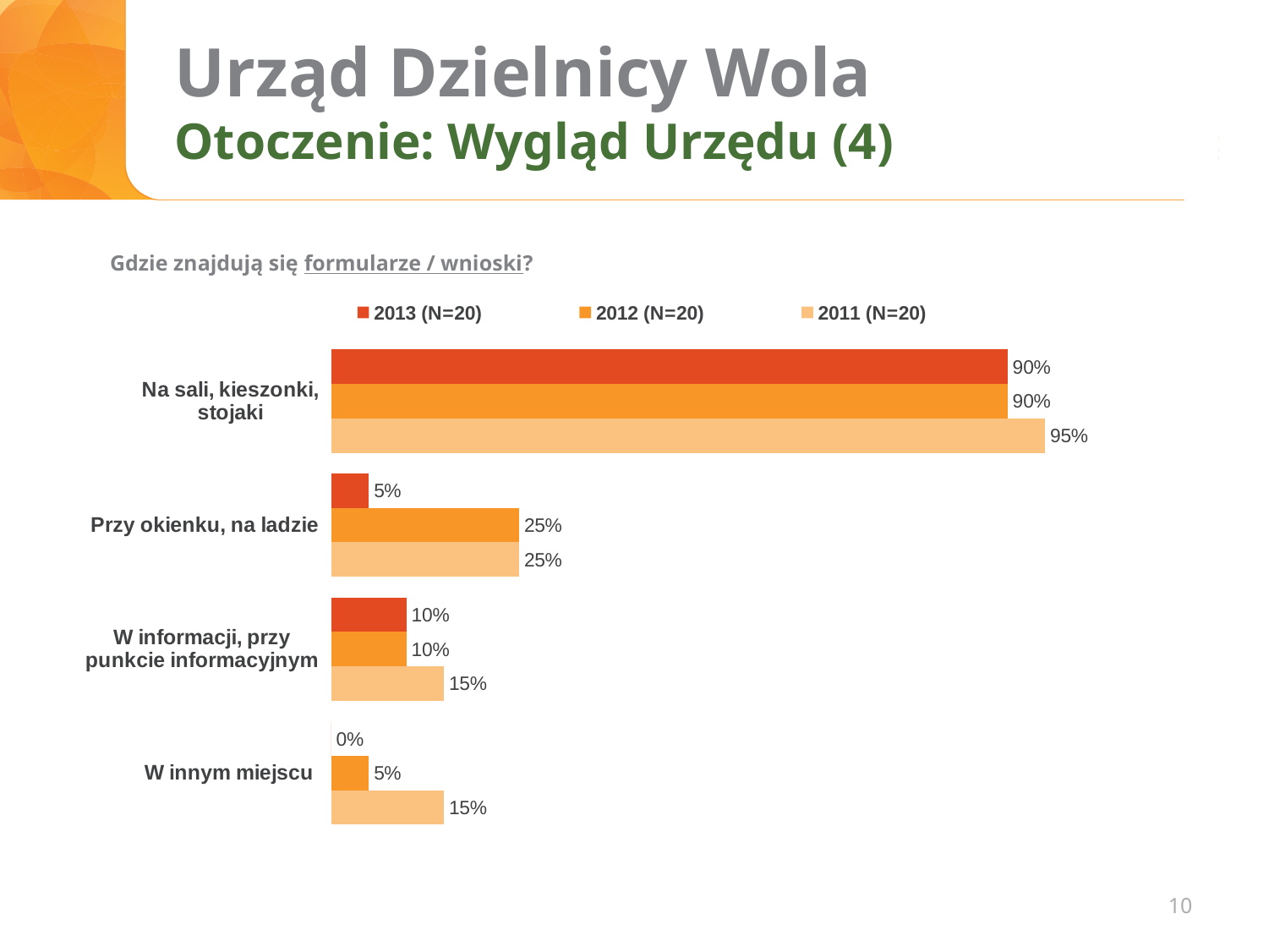
How many categories are shown on the chart? 4 Which category has the highest value in the 2011 (N=20) series? Na sali, kieszonki, stojaki What is the difference between the 2012 (N=20) and 2013 (N=20) values for "Przy okienku, na ladzie"? 20% What is the value for "W informacji, przy punkcie informacyjnym" in the 2013 (N=20) series? 10% Which category has the lowest value in the 2013 (N=20) series? W innym miejscu What is the value for "Na sali, kieszonki, stojaki" in the 2013 (N=20) series? 90% What is the value for "W innym miejscu" in the 2011 (N=20) series? 15% What is the value for "Przy okienku, na ladzie" in the 2012 (N=20) series? 25% How many series does the legend list? 3 What question does the chart answer, according to the text above it? Gdzie znajdują się formularze / wnioski? What kind of chart is shown on the slide? Bar chart Which is larger for "W informacji, przy punkcie informacyjnym": the 2011 (N=20) value or the 2012 (N=20) value? 2011 (N=20)